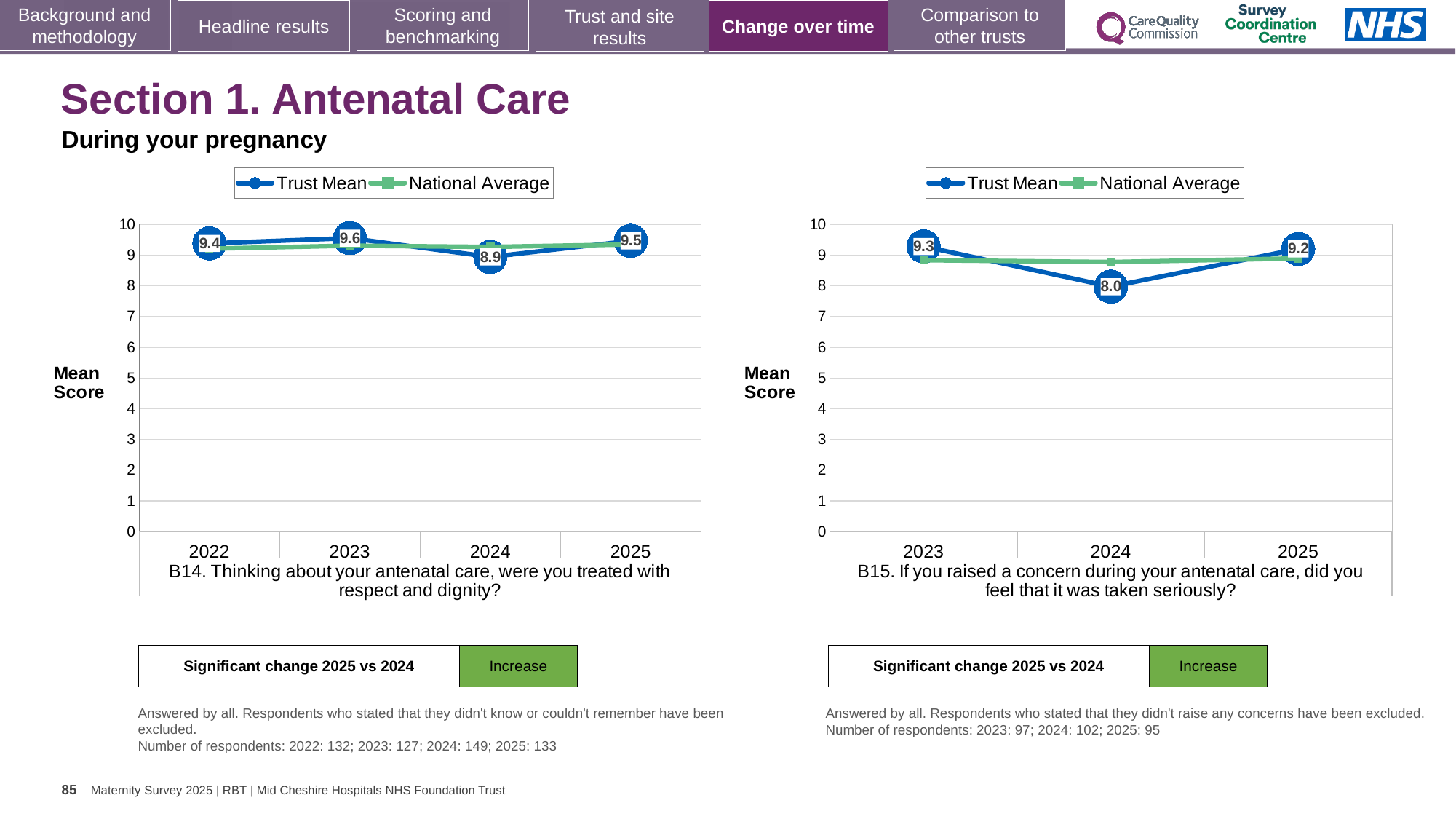
In the B15 chart (right), what is the Trust Mean score for 2024? 8.0 In the B15 chart (right), which year has the lowest Trust Mean score? 2024 In the B14 chart (left), what is the difference between the Trust Mean scores for 2023 and 2024? 0.7 In the B14 chart (left), what is the Trust Mean score for 2024? 8.9 In the B14 chart (left), which year has the highest Trust Mean score? 2023 In the B14 chart (left), which year has the lowest Trust Mean score? 2024 In the B15 chart (right), is the National Average for 2024 greater or less than 8? greater In the B15 chart (right), what is the Trust Mean score for 2025? 9.2 How many years are shown on the x axis of the B14 chart (left)? 4 In the B15 chart (right), what is the difference between the Trust Mean scores for 2025 and 2024? 1.2 How many series does the legend of the B15 chart (right) list? 2 In the B14 chart (left), what is the Trust Mean score for 2023? 9.6